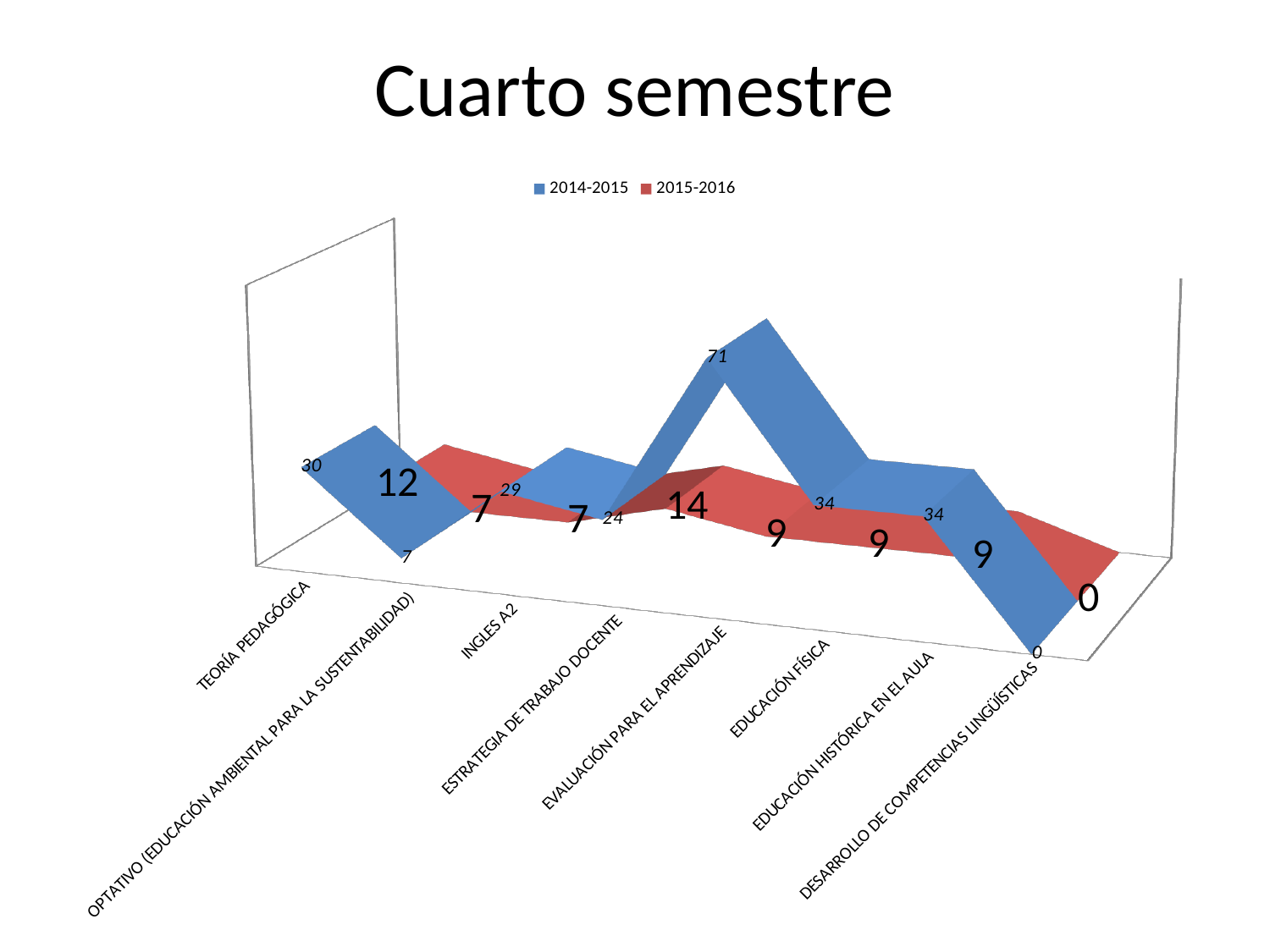
What is the 2014-2015 value for TEORÍA PEDAGÓGICA? 30 How many categories are plotted along the x axis? 8 What kind of chart is shown on the slide? Line chart What is the 2015-2016 value for ESTRATEGIA DE TRABAJO DOCENTE? 14 How many series does the legend list? 2 Which category has the highest 2014-2015 value? EVALUACIÓN PARA EL APRENDIZAJE What is the 2015-2016 value for TEORÍA PEDAGÓGICA? 12 What is the title of the chart? Cuarto semestre Which category has the lowest 2015-2016 value? DESARROLLO DE COMPETENCIAS LINGÜÍSTICAS What is the difference between the 2014-2015 values for EVALUACIÓN PARA EL APRENDIZAJE and EDUCACIÓN FÍSICA? 37 For TEORÍA PEDAGÓGICA, which series has the larger value, 2014-2015 or 2015-2016? 2014-2015 What is the 2014-2015 value for EVALUACIÓN PARA EL APRENDIZAJE? 71